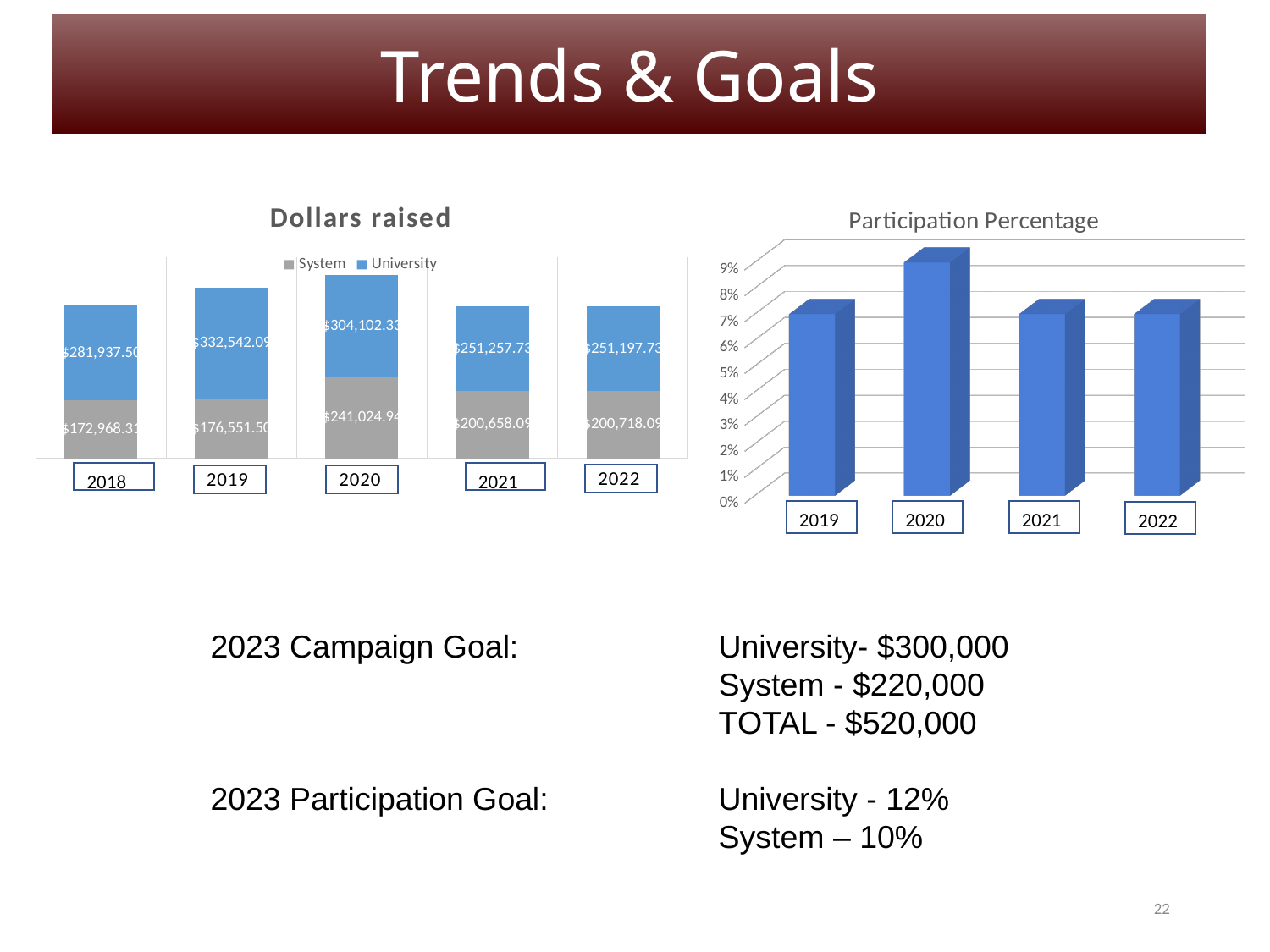
In the 'Dollars raised' chart, is the System value larger in 2020 or in 2021? 2020 In the 'Dollars raised' chart, which year has the highest System value? 2020 In the 'Dollars raised' chart, what is the total of the 2020 bar (System plus University)? $545,127.27 In the 'Dollars raised' chart, what is the University value for 2020? $304,102.33 In the 'Dollars raised' chart, what is the System value for 2021? $200,658.09 How many years are shown on the 'Dollars raised' chart? 5 How many years are shown on the 'Participation Percentage' chart? 4 In the 'Participation Percentage' chart, is the value for 2020 greater or less than 8%? greater How many series does the legend of the 'Dollars raised' chart list? 2 In the 'Participation Percentage' chart, which year has the highest participation? 2020 What kind of chart is the 'Dollars raised' chart? Stacked bar chart In the 'Dollars raised' chart, what is the difference between the University values for 2021 and 2022? $60.00